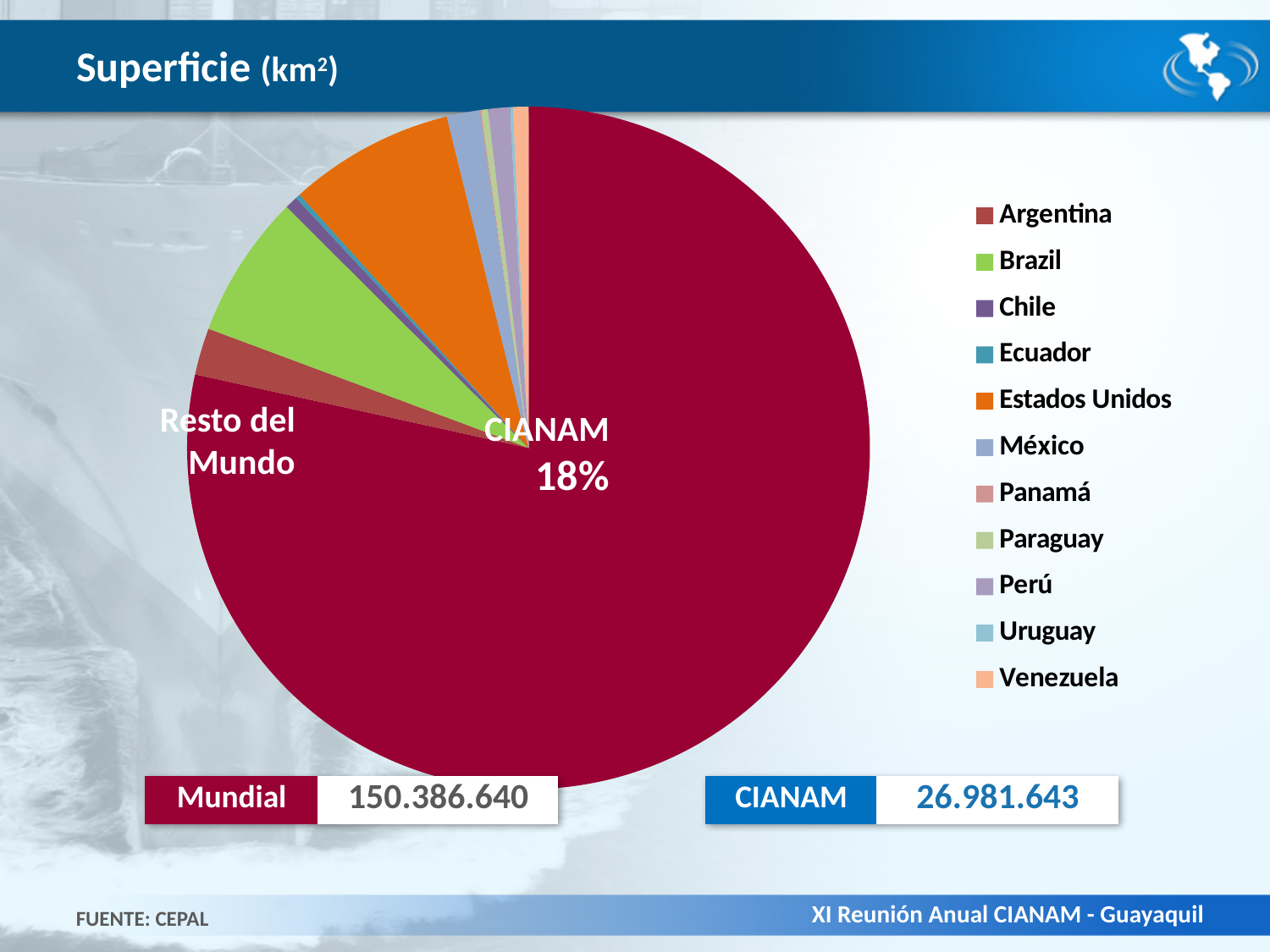
Which slice is larger, Brazil or Chile? Brazil What is the title of the chart? Superficie (km²) What is the CIANAM surface value shown on the slide? 26.981.643 Which slice is larger, Brazil or Argentina? Brazil What share of the pie does CIANAM represent? 18% How many entries does the chart legend list? 11 What source is cited for the chart data? CEPAL What is the Mundial surface value shown on the slide? 150.386.640 Among the countries listed in the legend, which has the largest slice? Estados Unidos Which slice is larger, Estados Unidos or México? Estados Unidos What kind of chart is shown on the slide? pie chart Which slice of the pie is the largest? Resto del Mundo